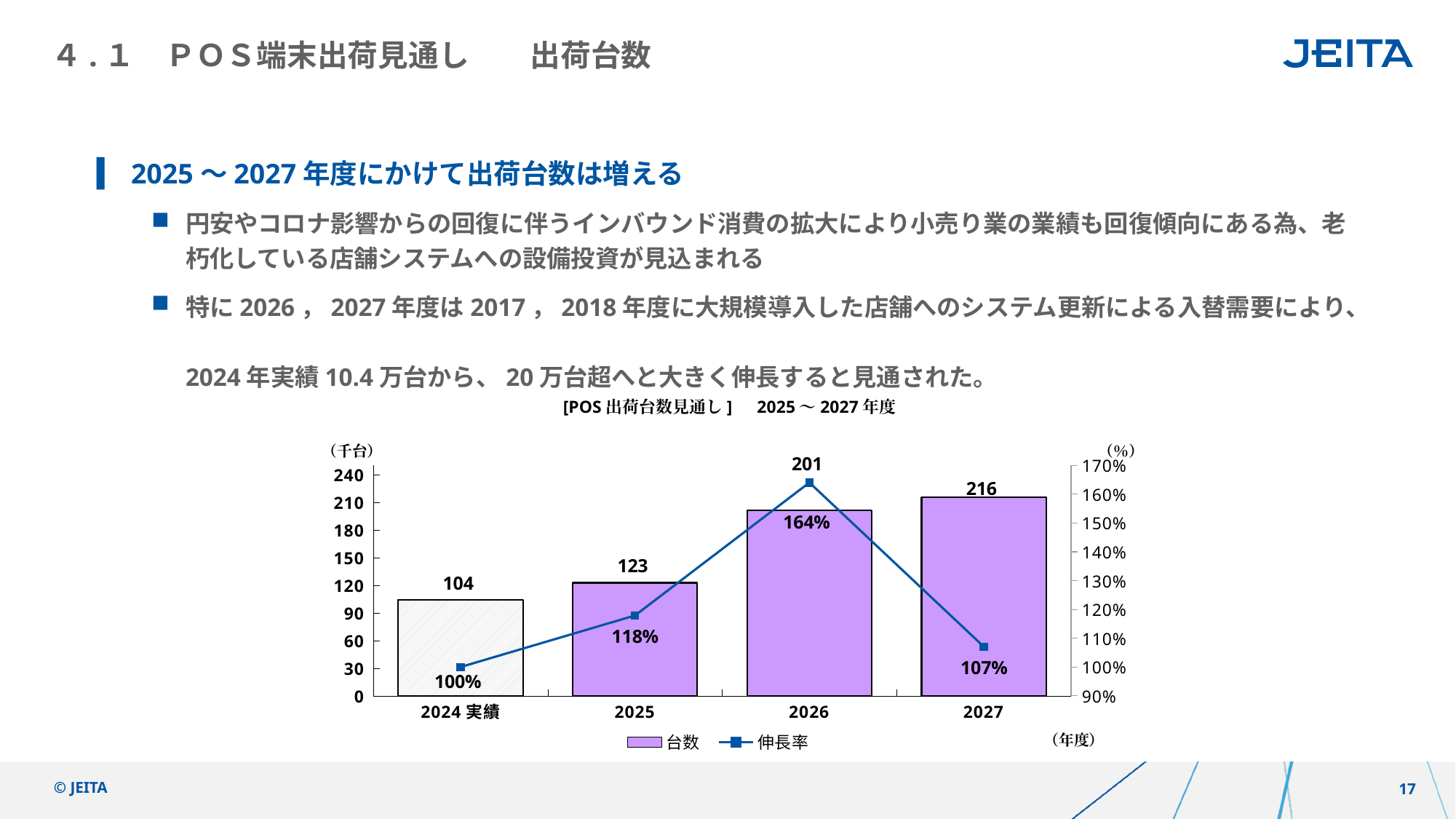
Which year has the lowest 伸長率? 2024 実績 What is the 台数 value for 2026? 201 How many series does the legend list? 2 Which is larger, the 台数 for 2025 or for 2024 実績? 2025 What is the 伸長率 value for 2025? 118% What is the difference in 台数 between 2027 and 2026? 15 Which year has the highest 台数? 2027 What is the 台数 value for 2024 実績? 104 Which year has the highest 伸長率? 2026 Does the 台数 rise or fall from 2024 実績 to 2027? rise How many years are shown on the x axis? 4 What is the unit shown on the left axis? 千台